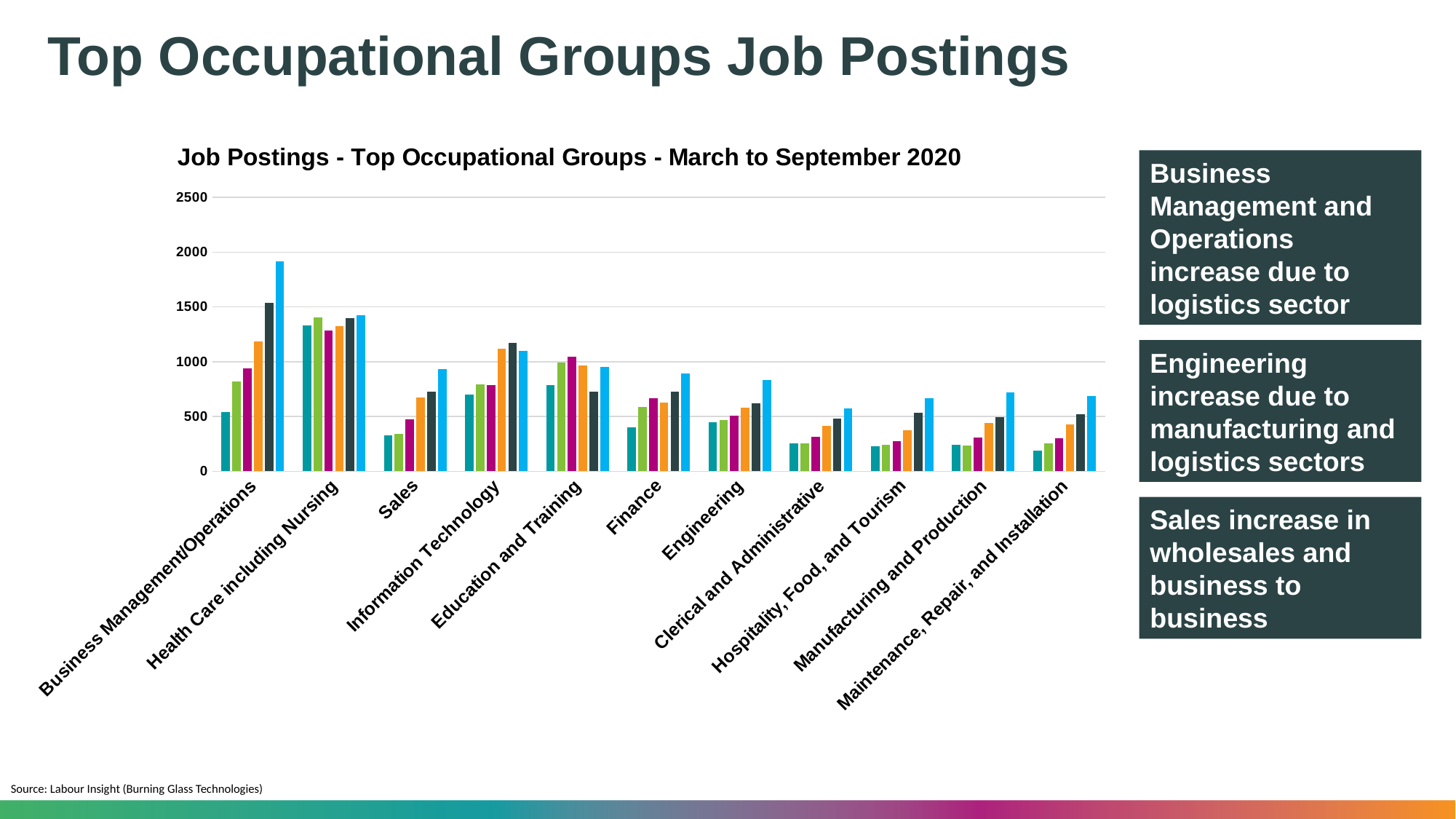
What is the highest value labelled on the y axis of the chart? 2500 Is the light blue bar for Maintenance, Repair, and Installation greater or less than 500? greater Is the tallest bar for Information Technology greater or less than 1000? greater Is the tallest bar for Hospitality, Food, and Tourism greater or less than 1000? less Which has the taller bars overall, Health Care including Nursing or Sales? Health Care including Nursing Which occupational group has the tallest bar in the chart? Business Management/Operations What is the title of the chart? Job Postings - Top Occupational Groups - March to September 2020 How many bars are plotted for each occupational group? 6 How many occupational group categories are shown on the x axis of the chart? 11 What kind of chart is shown on the slide? bar chart